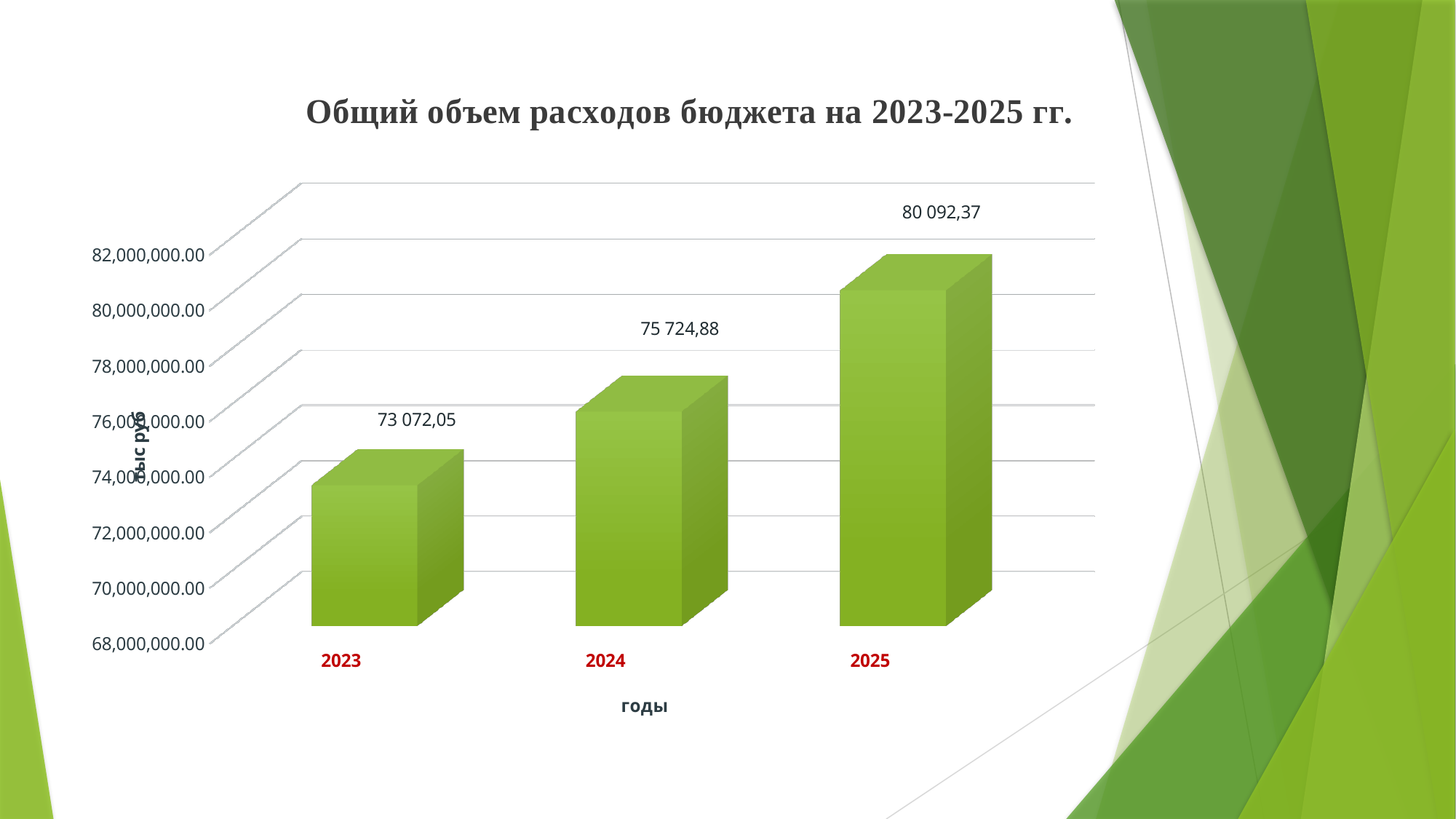
What is the value shown for 2025? 80 092,37 Is the bar for 2023 greater or less than 72,000,000.00 on the axis? greater How many years are shown on the chart? 3 Do the values rise or fall from 2023 to 2025? rise Which is larger, the value for 2024 or the value for 2025? 2025 What is the difference between the values for 2025 and 2023? 7 020,32 What is the value shown for 2023? 73 072,05 What kind of chart is shown on the slide? bar chart Which year has the lowest value? 2023 What is the difference between the values for 2024 and 2023? 2 652,83 What is the value shown for 2024? 75 724,88 Which year has the highest value? 2025